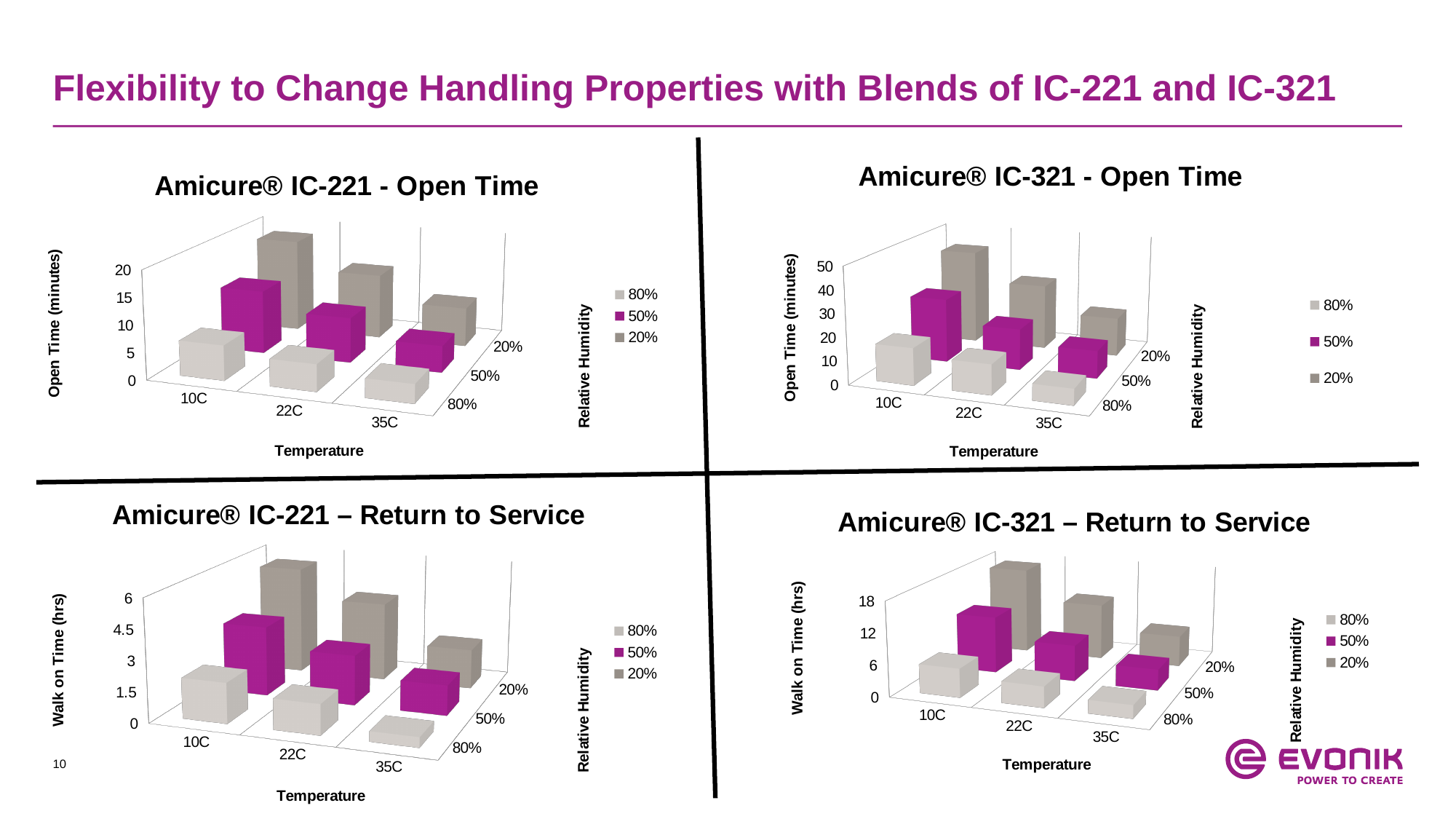
How many temperature categories are shown on the x axis of the Amicure® IC-321 - Open Time chart? 3 In the Amicure® IC-221 – Return to Service chart, which temperature and humidity combination has the lowest walk on time? 35C at 80% How many series does the legend of the Amicure® IC-221 – Return to Service chart list? 3 What kind of chart is the Amicure® IC-221 - Open Time chart? bar chart What is the y-axis label of the Amicure® IC-321 – Return to Service chart? Walk on Time (hrs) How many charts are shown on the slide? 4 What is the title of the legend in the Amicure® IC-221 - Open Time chart? Relative Humidity In the Amicure® IC-321 – Return to Service chart, does the walk on time for the 50% humidity series rise or fall as temperature increases from 10C to 35C? fall In the Amicure® IC-221 - Open Time chart, does the open time for the 20% humidity series rise or fall as temperature increases from 10C to 35C? fall In the Amicure® IC-321 - Open Time chart, at 10C, which is larger: the open time at 20% humidity or at 80% humidity? 20% In the Amicure® IC-221 - Open Time chart, at which temperature is the open time for 20% relative humidity highest? 10C In the Amicure® IC-321 – Return to Service chart, which humidity series has the highest walk on time at 22C? 20%